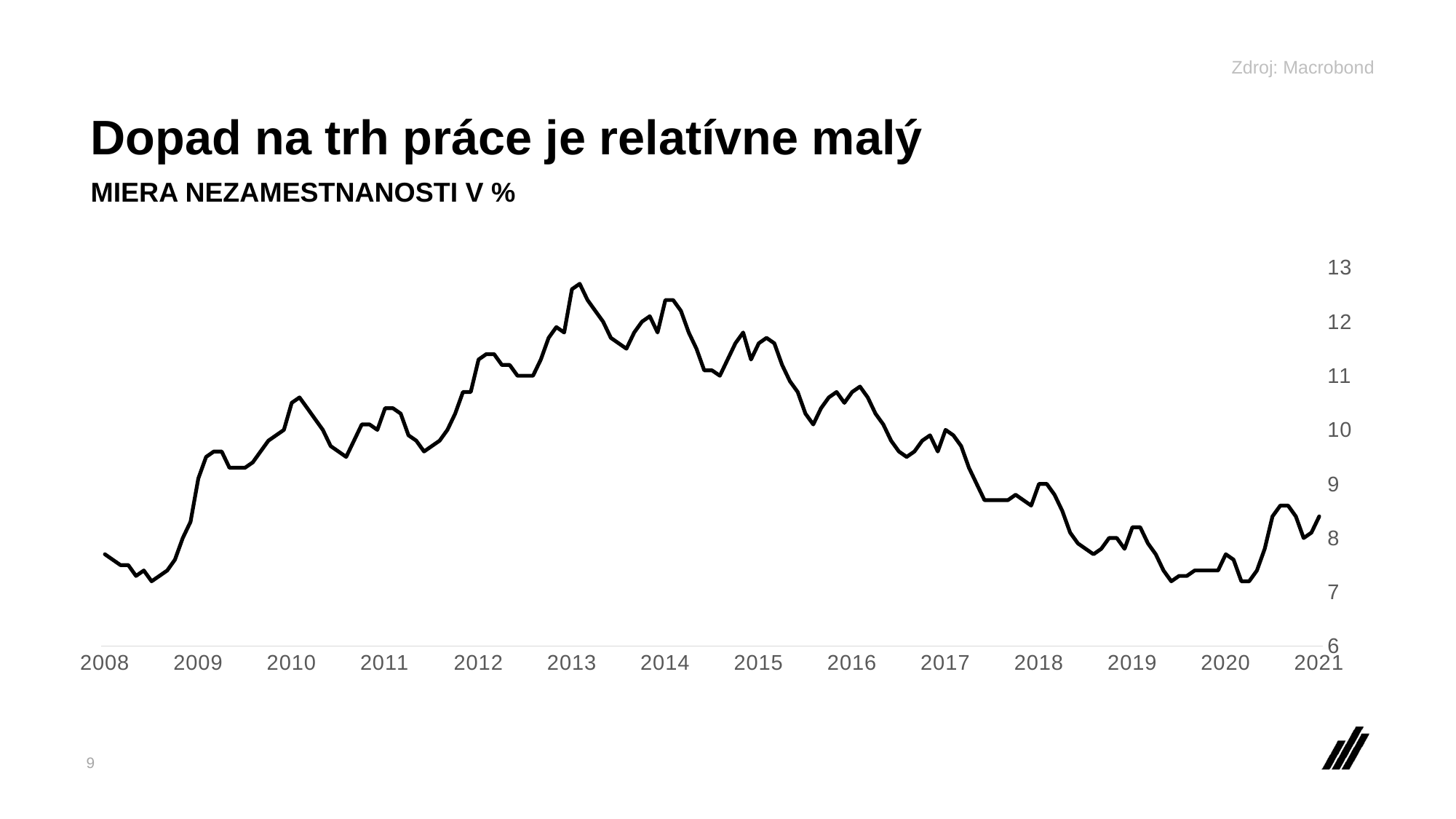
In which year does the unemployment rate reach its highest point? 2013 How many years are labelled on the x axis of the chart? 14 Is the unemployment rate at the start of 2020 greater or less than 8? less Is the peak unemployment rate in 2013 greater or less than 12? greater What source is cited for the chart? Macrobond Is the unemployment rate at the start of 2015 greater or less than 11? greater What kind of chart is shown on the slide? line chart Does the unemployment rate generally rise or fall between 2013 and 2019? fall What is the title of the chart on the slide? MIERA NEZAMESTNANOSTI V % Which is higher, the unemployment rate at the start of 2016 or at the start of 2020? 2016